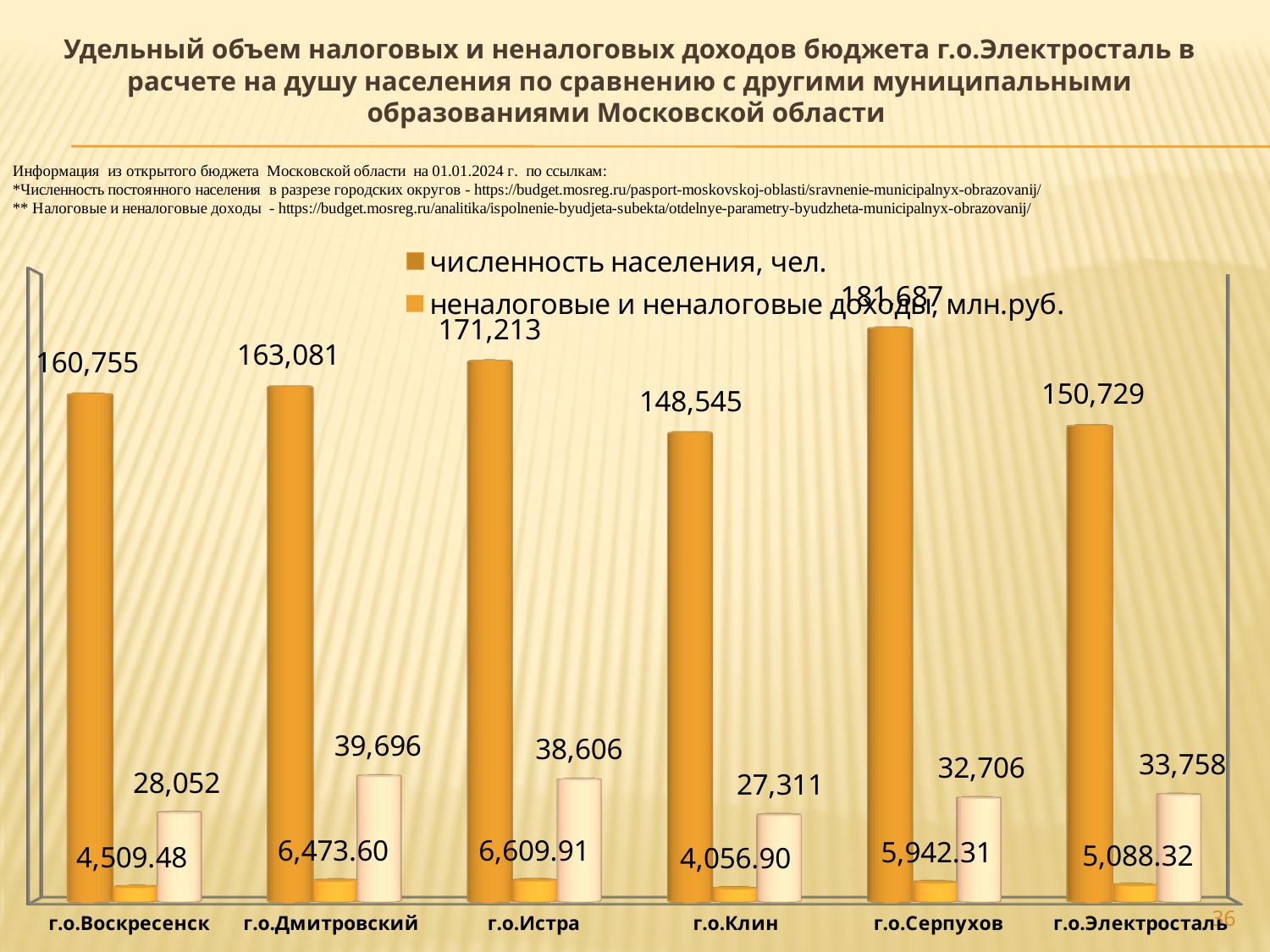
What is the difference in population between г.о.Серпухов and г.о.Клин? 33,142 What is the value of налоговые и неналоговые доходы, млн.руб. for г.о.Воскресенск? 4,509.48 Which has higher налоговые и неналоговые доходы, млн.руб., г.о.Серпухов or г.о.Электросталь? г.о.Серпухов Which municipality has the lowest value of налоговые и неналоговые доходы, млн.руб.? г.о.Клин Which municipality has the highest population (численность населения, чел.)? г.о.Серпухов Which has a larger population, г.о.Дмитровский or г.о.Воскресенск? г.о.Дмитровский What is the population (численность населения, чел.) shown for г.о.Электросталь? 150,729 How many municipalities are shown on the x axis of the chart? 6 What kind of chart is shown on the slide? bar chart What is the value of налоговые и неналоговые доходы, млн.руб. for г.о.Истра? 6,609.91 How many series does the chart legend list? 2 Which municipality has the lowest population (численность населения, чел.)? г.о.Клин